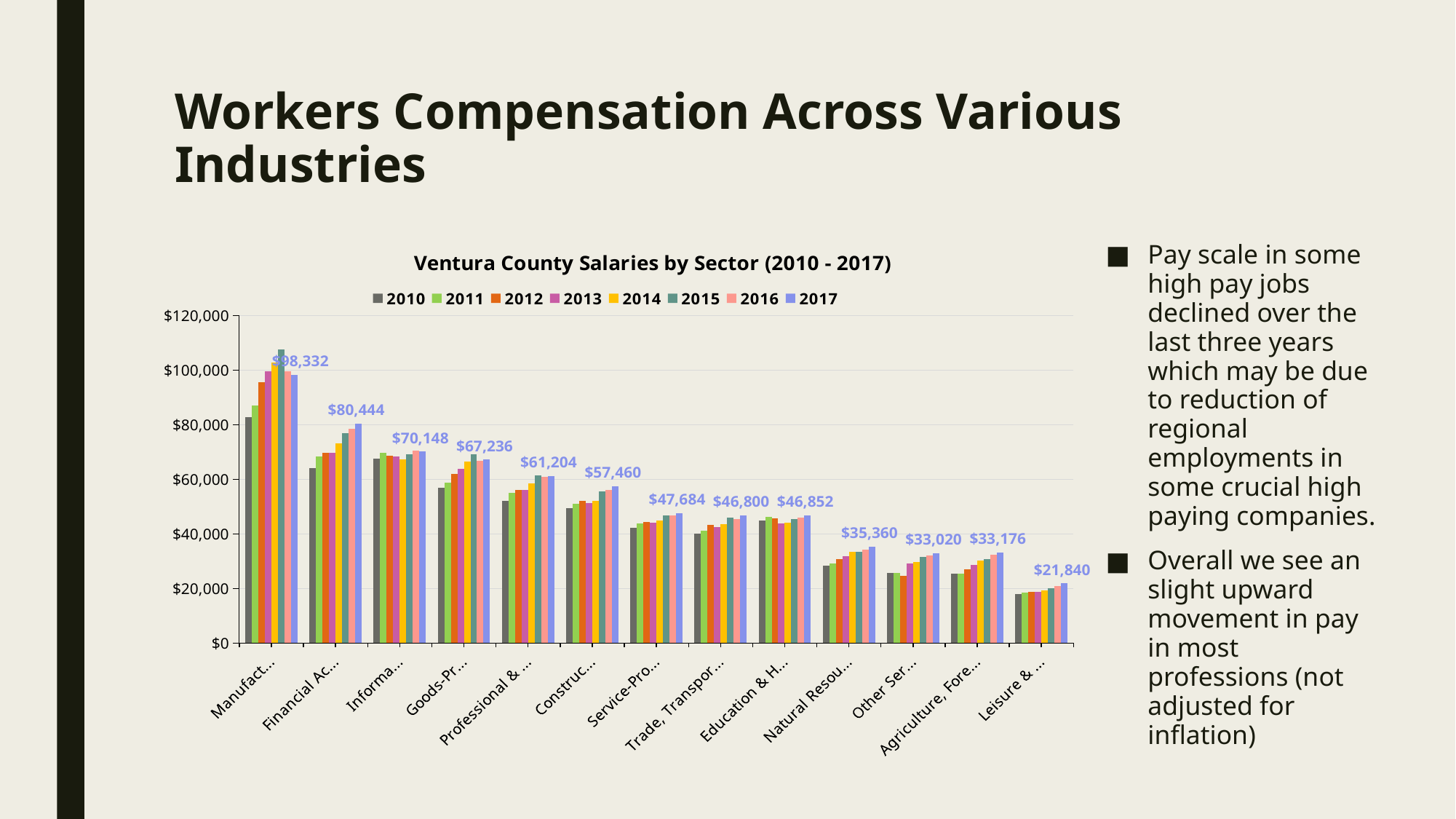
Is the 2010 value for 'Financial Ac...' greater or less than $80,000? less Which has the larger 2017 value: 'Professional & ...' or 'Construc...'? Professional & ... What is the labelled 2017 value for the category labelled 'Leisure & ...'? $21,840 What is the difference between the 2017 values for 'Financial Ac...' ($80,444) and 'Informa...' ($70,148)? $10,296 What is the labelled 2017 value for the category labelled 'Manufact...'? $98,332 How many series does the chart legend list? 8 How many sector categories are plotted along the x axis? 13 Which category has the highest labelled 2017 value? Manufact... What is the title of the chart? Ventura County Salaries by Sector (2010 - 2017) Do the bars for 'Natural Resou...' rise or fall from 2010 to 2017? rise Which category has the lowest labelled 2017 value? Leisure & ... What kind of chart is shown on the slide? Bar chart